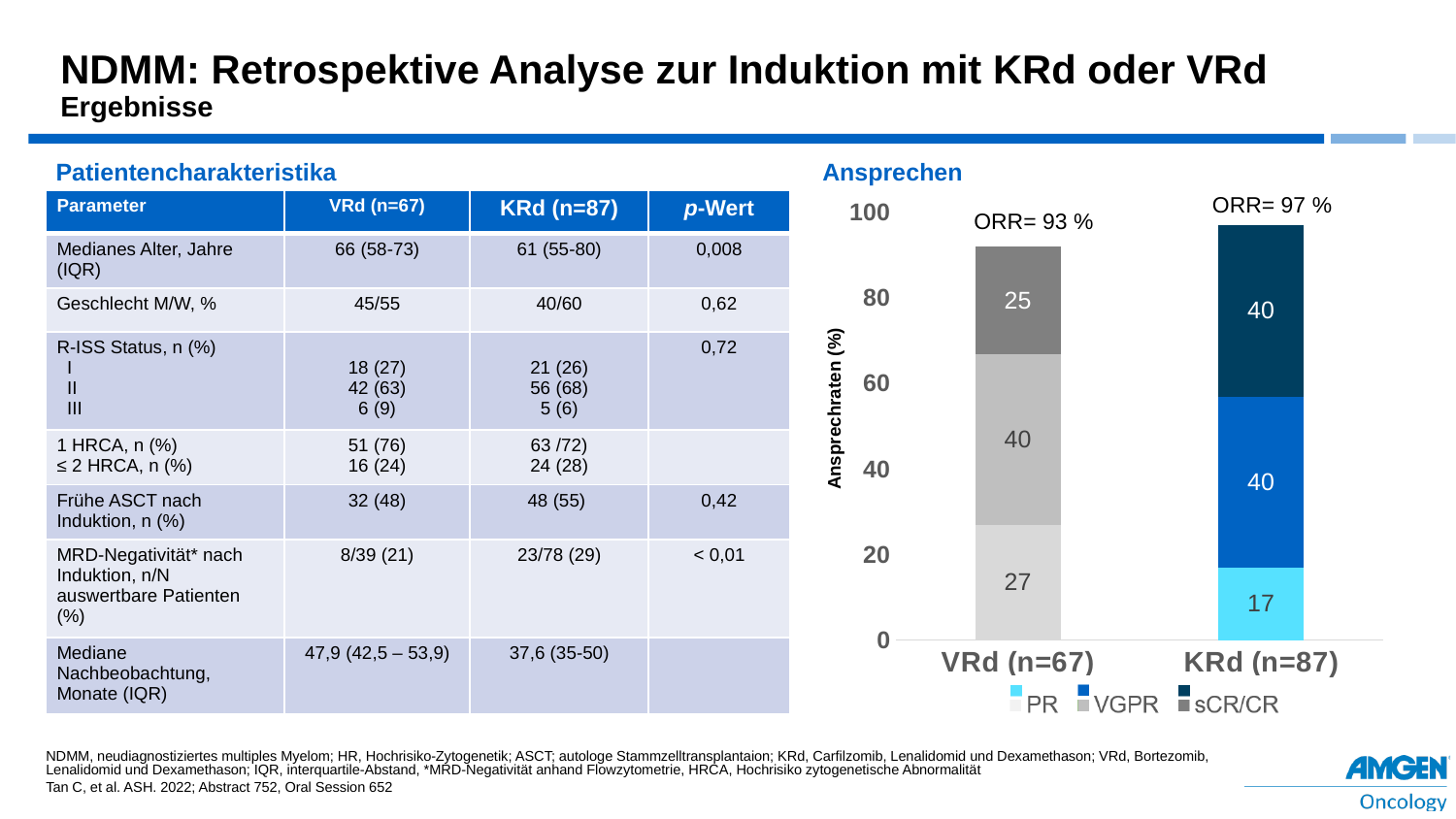
In the "Ansprechen" chart, what is the difference between the PR values for VRd (n=67) and KRd (n=87)? 10 In the "Ansprechen" chart, what is the sCR/CR value for VRd (n=67)? 25 In the "Ansprechen" chart, what is the sCR/CR value for KRd (n=87)? 40 In the "Ansprechen" chart, what is the PR value for VRd (n=67)? 27 What is the ORR shown above the KRd (n=87) bar in the "Ansprechen" chart? ORR= 97 % In the "Ansprechen" chart, what is the difference between the sCR/CR values for KRd (n=87) and VRd (n=67)? 15 What kind of chart is shown under "Ansprechen"? Stacked bar chart In the "Ansprechen" chart, which group has the larger PR value, VRd (n=67) or KRd (n=87)? VRd (n=67) How many series does the legend of the "Ansprechen" chart list? 3 In the "Ansprechen" chart, what is the VGPR value for VRd (n=67)? 40 In the "Ansprechen" chart, what is the total of the stacked bar for KRd (n=87)? 97 In the "Ansprechen" chart, what is the PR value for KRd (n=87)? 17